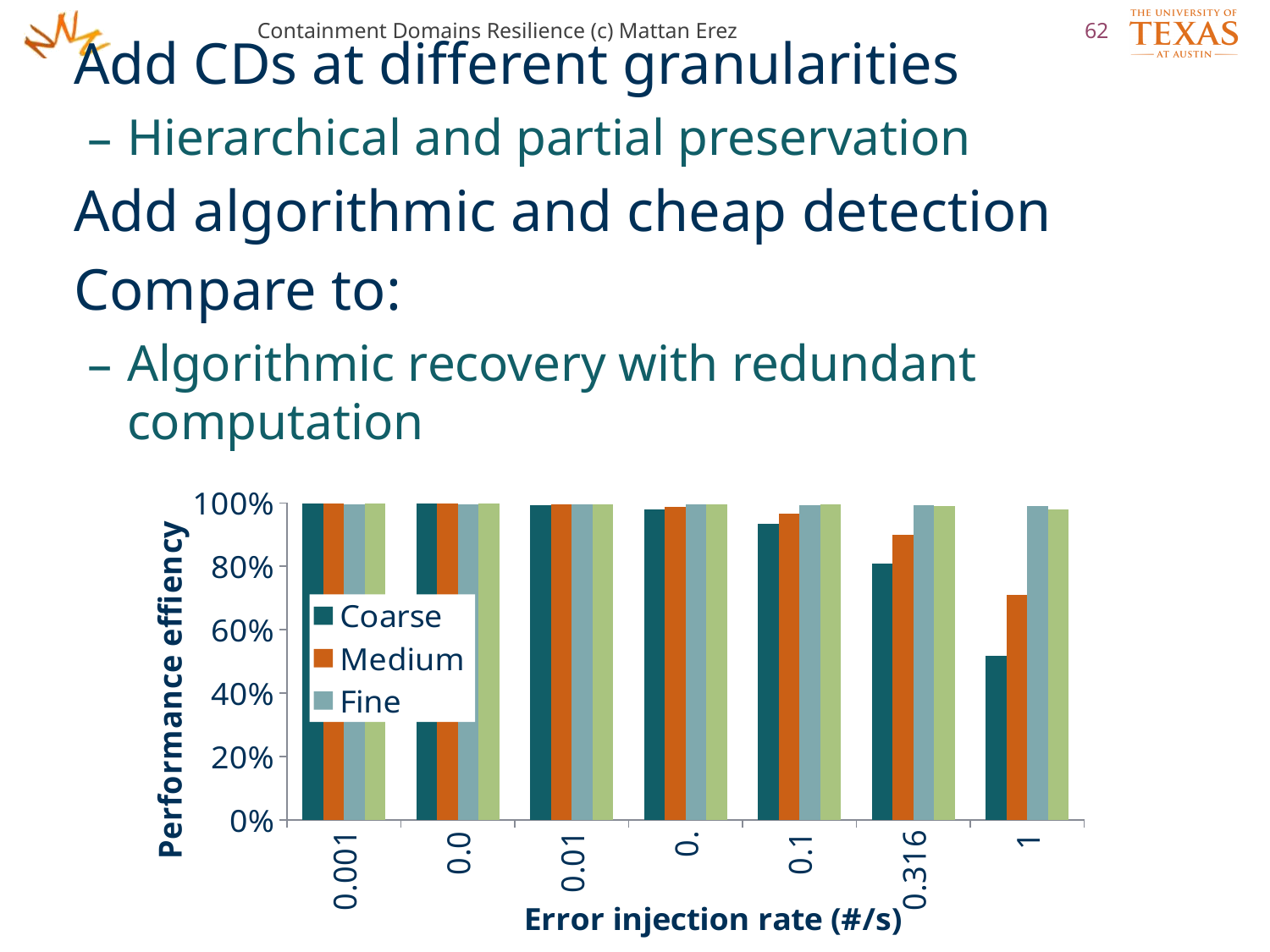
What is the title of the x axis? Error injection rate (#/s) How many series does the chart's legend list? 3 Is the Medium value at an error injection rate of 1 greater or less than 80%? less At which error injection rate is the Coarse series lowest? 1 At an error injection rate of 1, which is larger, the Coarse value or the Fine value? Fine Is the Coarse value at an error injection rate of 1 greater or less than 60%? less How many error injection rate categories are plotted along the x axis? 7 Is the Medium value at an error injection rate of 0.316 greater or less than 80%? greater Do the Coarse values rise or fall as the error injection rate increases along the x axis? fall What is the title of the y axis? Performance effiency What kind of chart is shown on the slide? bar chart